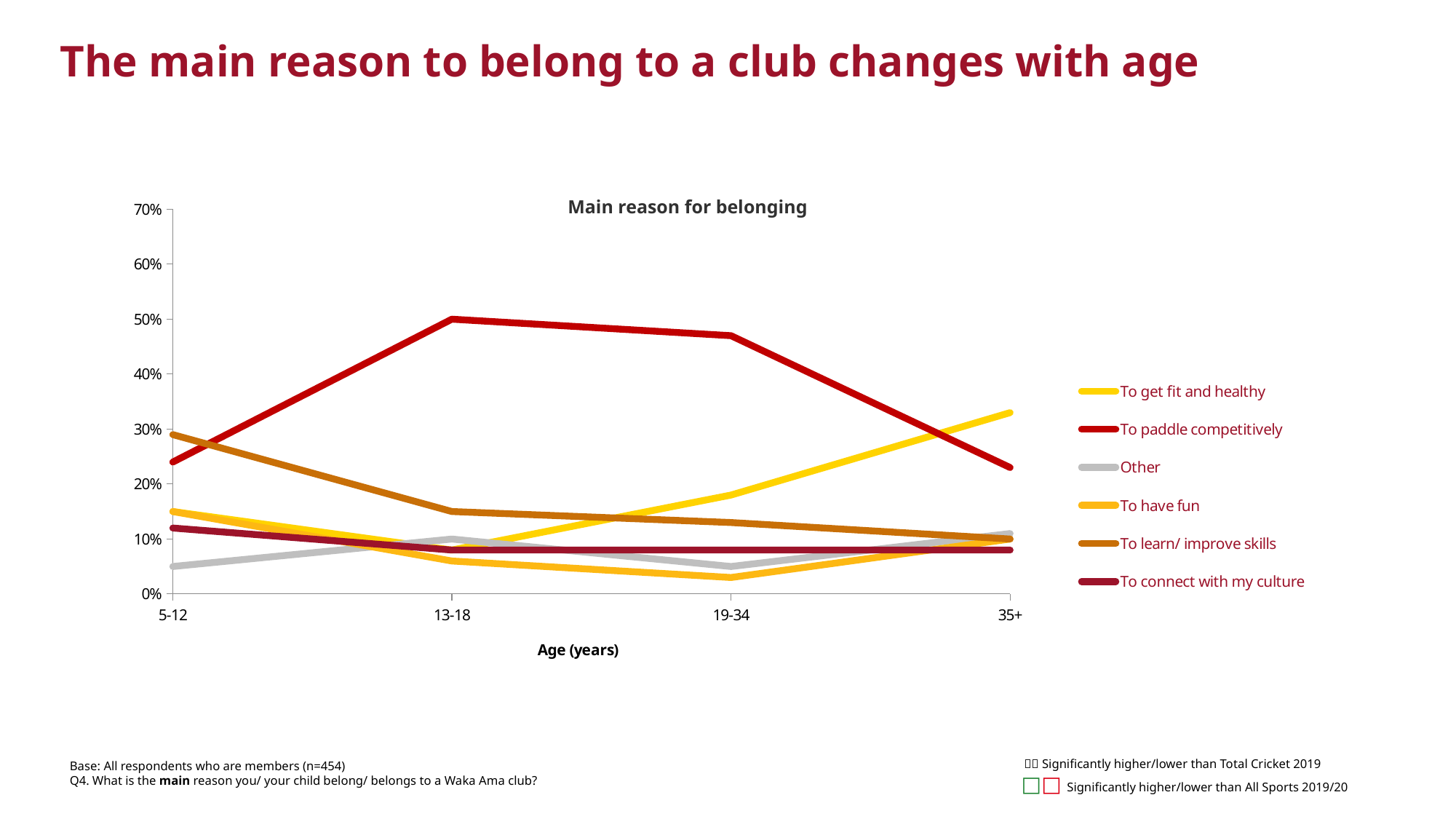
How many series does the legend list? 6 At 5-12, which is larger: 'To learn/ improve skills' or 'To get fit and healthy'? To learn/ improve skills Is the value for 'To paddle competitively' at 19-34 greater or less than 40%? greater Which reason has the highest value for the 13-18 age group? To paddle competitively Does the value for 'To get fit and healthy' rise or fall from 13-18 to 35+? rise Is the value for 'To get fit and healthy' at 35+ greater or less than 30%? greater Which reason has the lowest value for the 19-34 age group? To have fun Which reason has the highest value for the 35+ age group? To get fit and healthy How many age groups are shown on the x axis? 4 What kind of chart is shown on the slide? line chart What is the title of the chart? Main reason for belonging Is the value for 'To have fun' at 19-34 greater or less than 10%? less